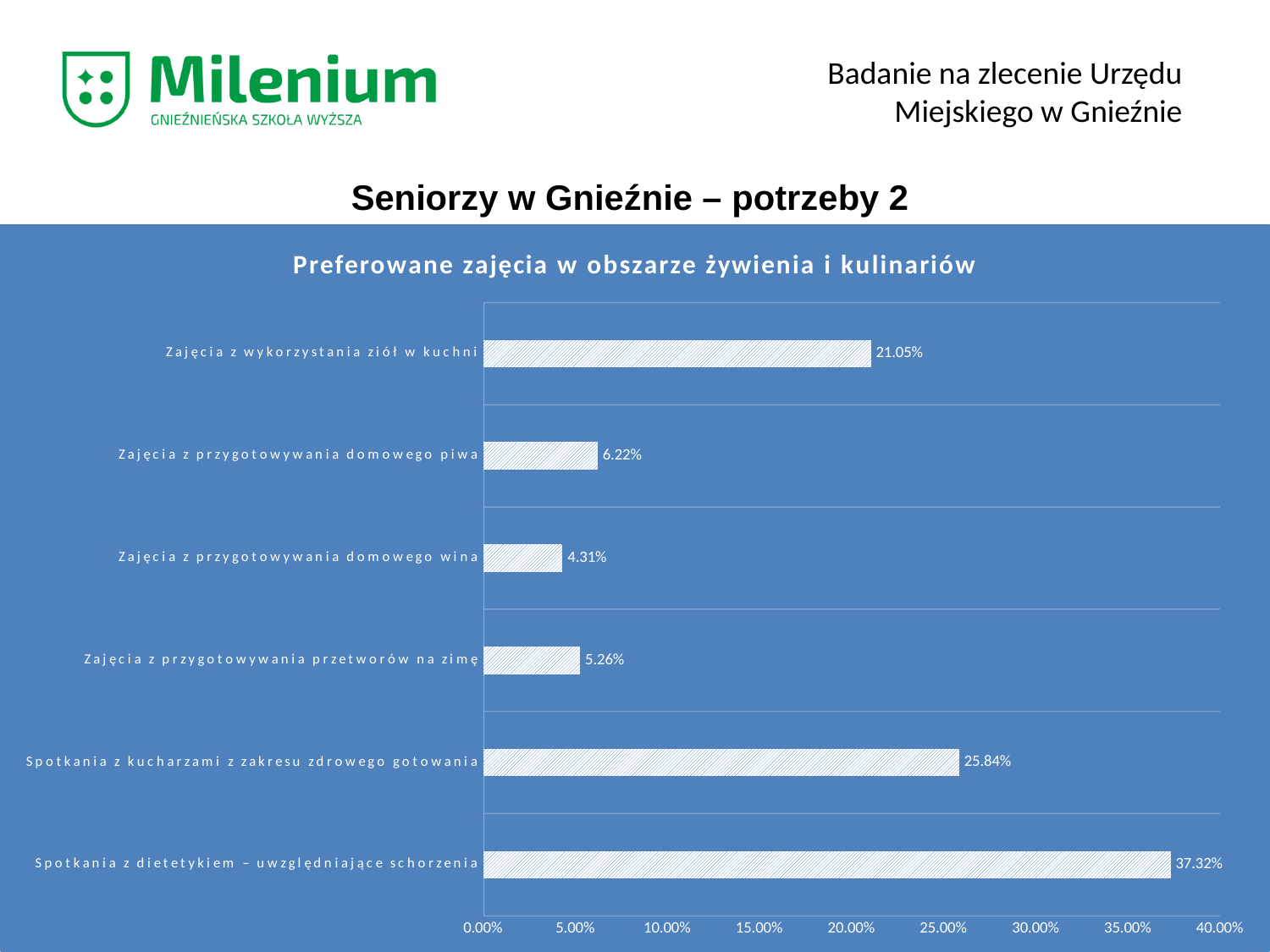
What is the value for "Spotkania z dietetykiem – uwzględniające schorzenia"? 37.32% What is the title of the chart? Preferowane zajęcia w obszarze żywienia i kulinariów What is the difference between the values for "Spotkania z dietetykiem – uwzględniające schorzenia" and "Spotkania z kucharzami z zakresu zdrowego gotowania"? 11.48% What is the value for "Zajęcia z przygotowywania domowego piwa"? 6.22% How many categories are shown in the chart? 6 What is the value for "Zajęcia z wykorzystania ziół w kuchni"? 21.05% Is the value for "Spotkania z kucharzami z zakresu zdrowego gotowania" greater or less than 25.00%? greater Which category has the lowest value? Zajęcia z przygotowywania domowego wina Which is larger: the value for "Zajęcia z przygotowywania przetworów na zimę" or for "Zajęcia z przygotowywania domowego wina"? Zajęcia z przygotowywania przetworów na zimę What kind of chart is shown on the slide? bar chart Which category has the highest value? Spotkania z dietetykiem – uwzględniające schorzenia What is the maximum value shown on the horizontal axis? 40.00%